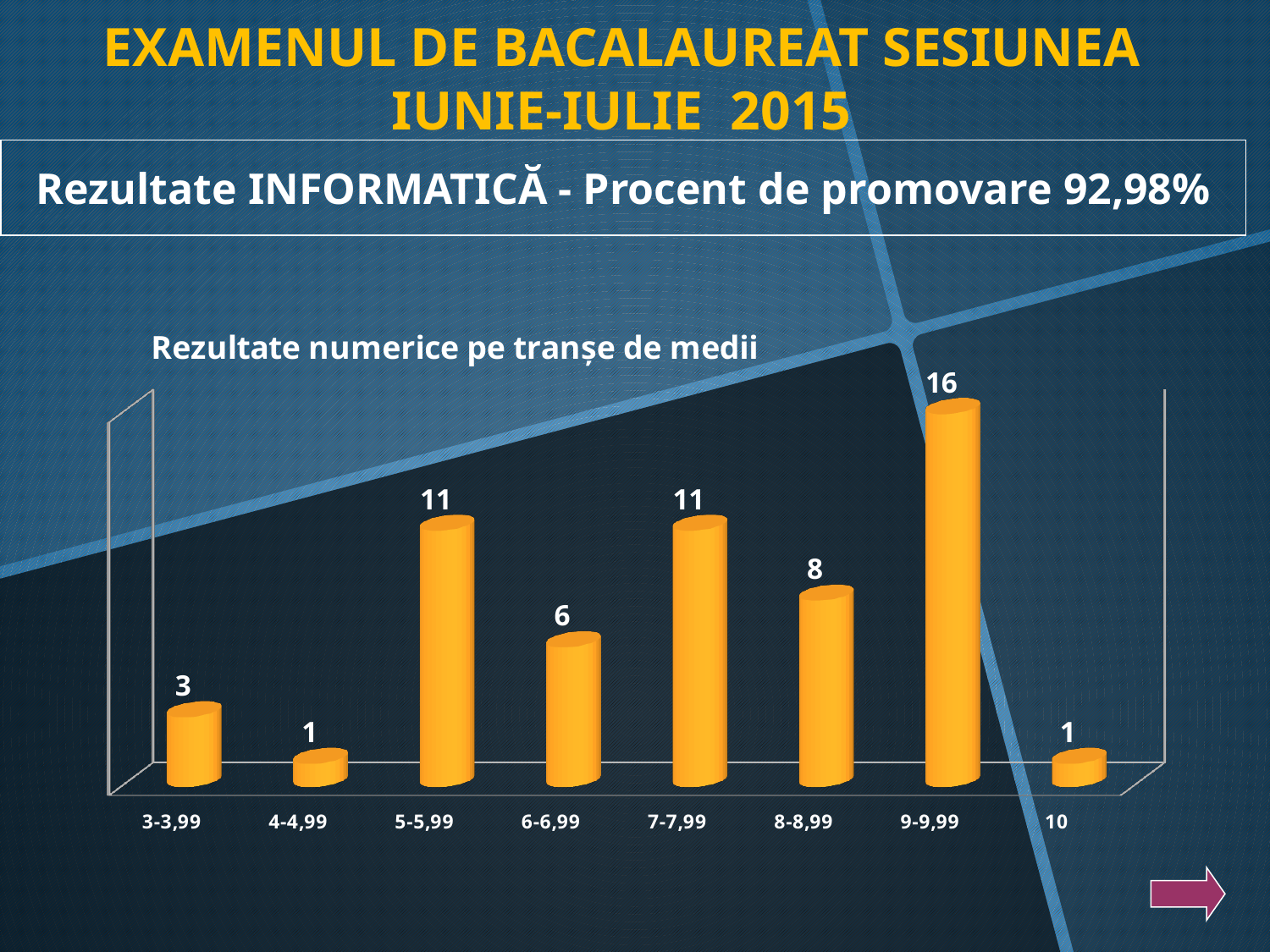
What is the difference between the values for 9-9,99 and 8-8,99? 8 What is the difference between the values for 7-7,99 and 6-6,99? 5 What is the value for the 10 category? 1 What is the value for the 5-5,99 category? 11 What kind of chart is shown on the slide? bar chart What is the value for the 9-9,99 category? 16 Which category has the highest value? 9-9,99 What is the value for the 3-3,99 category? 3 What is the title of the chart? Rezultate numerice pe tranșe de medii What is the total of the values for 3-3,99 and 4-4,99? 4 How many categories are shown on the x axis? 8 Which is larger, the value for 6-6,99 or the value for 8-8,99? 8-8,99